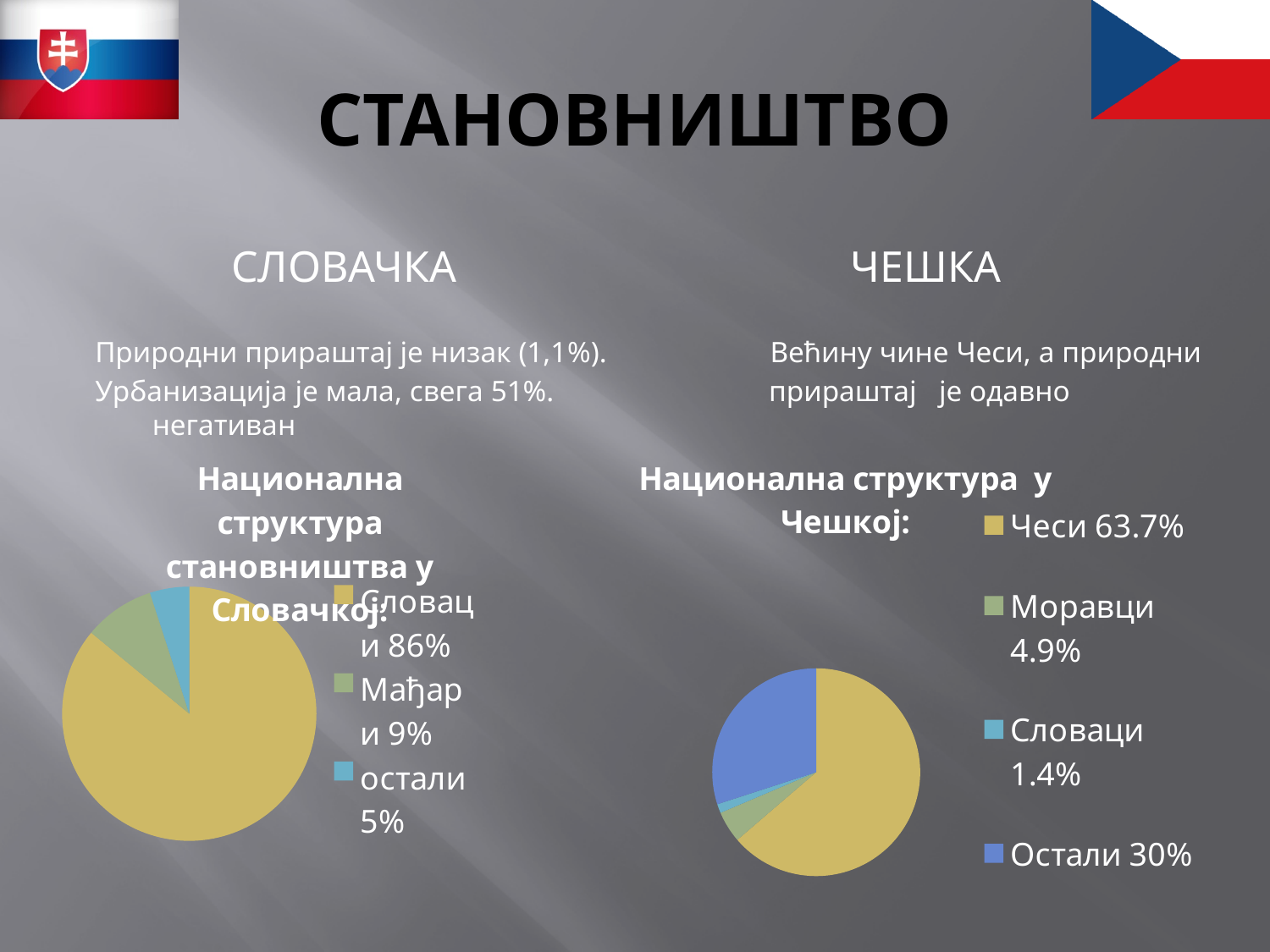
In the right pie chart (Национална структура у Чешкој), what is the difference between the shares for Чеси and Остали? 33.7% In the left pie chart (Национална структура становништва у Словачкој), what share is shown for Мађари? 9% In the right pie chart (Национална структура у Чешкој), what share is shown for Словаци? 1.4% In the left pie chart (Национална структура становништва у Словачкој), which group has the smallest slice? остали In the left pie chart (Национална структура становништва у Словачкој), how many groups does the legend list? 3 In the left pie chart (Национална структура становништва у Словачкој), what share is shown for Словаци? 86% In the right pie chart (Национална структура у Чешкој), what share is shown for Моравци? 4.9% In the left pie chart (Национална структура становништва у Словачкој), which group has the largest slice? Словаци In the right pie chart (Национална структура у Чешкој), what share is shown for Чеси? 63.7% In the right pie chart (Национална структура у Чешкој), how many groups does the legend list? 4 In the right pie chart (Национална структура у Чешкој), which group has the smallest slice? Словаци What type of chart is used on the left side of the slide for the national structure of Slovakia? Pie chart